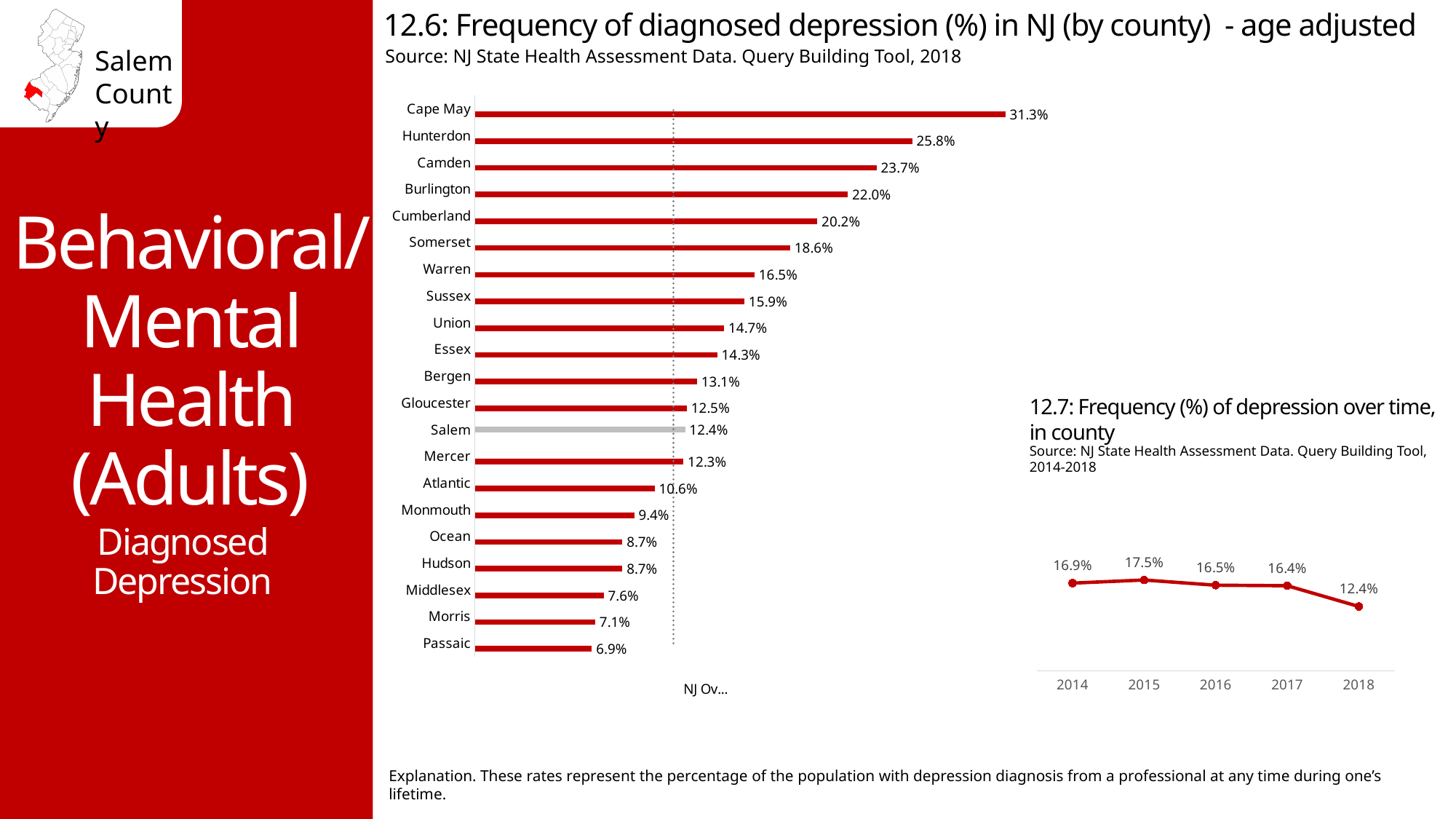
In chart 12.6 (Frequency of diagnosed depression by county), which county has the lowest value? Passaic In chart 12.6 (Frequency of diagnosed depression by county), which is larger, Camden or Cumberland? Camden In chart 12.6 (Frequency of diagnosed depression by county), which county has the highest value? Cape May In chart 12.7 (Frequency of depression over time, in county), what is the value for 2015? 17.5% In chart 12.6 (Frequency of diagnosed depression by county), what is the difference between Cape May and Passaic? 24.4% In chart 12.7 (Frequency of depression over time, in county), which year has the lowest value? 2018 What kind of chart is chart 12.6 (Frequency of diagnosed depression by county)? Bar chart What kind of chart is chart 12.7 (Frequency of depression over time, in county)? Line chart In chart 12.6 (Frequency of diagnosed depression by county), how many counties are plotted? 21 In chart 12.6 (Frequency of diagnosed depression by county), what is the value for Salem? 12.4% In chart 12.7 (Frequency of depression over time, in county), what is the difference between 2014 and 2018? 4.5% In chart 12.6 (Frequency of diagnosed depression by county), what is the value for Hunterdon? 25.8%